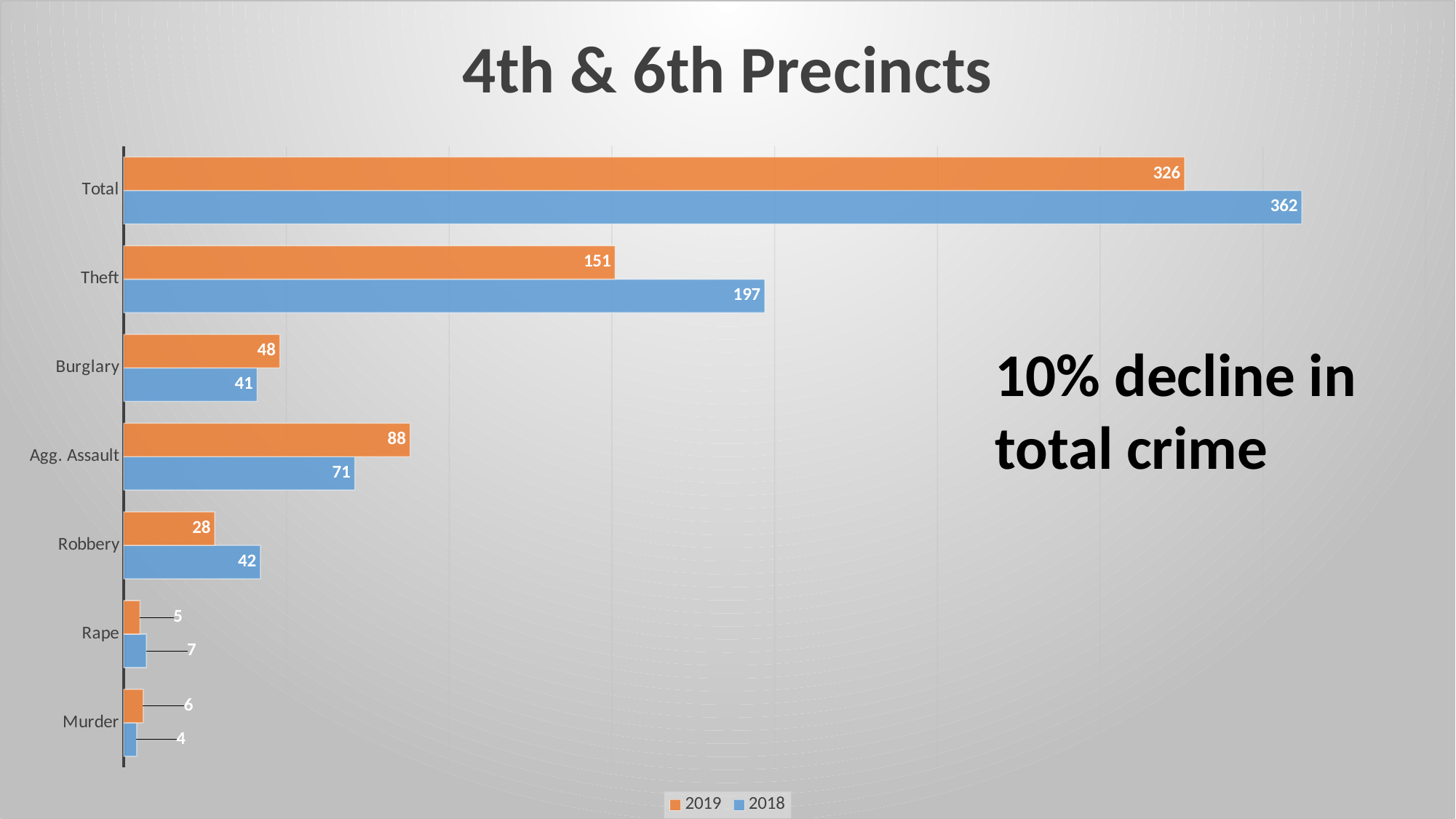
What is the 2019 value for Theft? 151 What is the 2019 value for Agg. Assault? 88 What is the difference between the 2018 and 2019 values for Total? 36 What is the difference between the 2018 and 2019 values for Theft? 46 What type of chart is shown on the slide? Bar chart What is the 2018 value for Robbery? 42 What is the 2018 value for Total? 362 How many series does the legend list? 2 For Burglary, which year has the larger value, 2018 or 2019? 2019 How many categories are shown on the y axis? 7 Which category has the lowest 2018 value? Murder Excluding Total, which category has the highest 2018 value? Theft